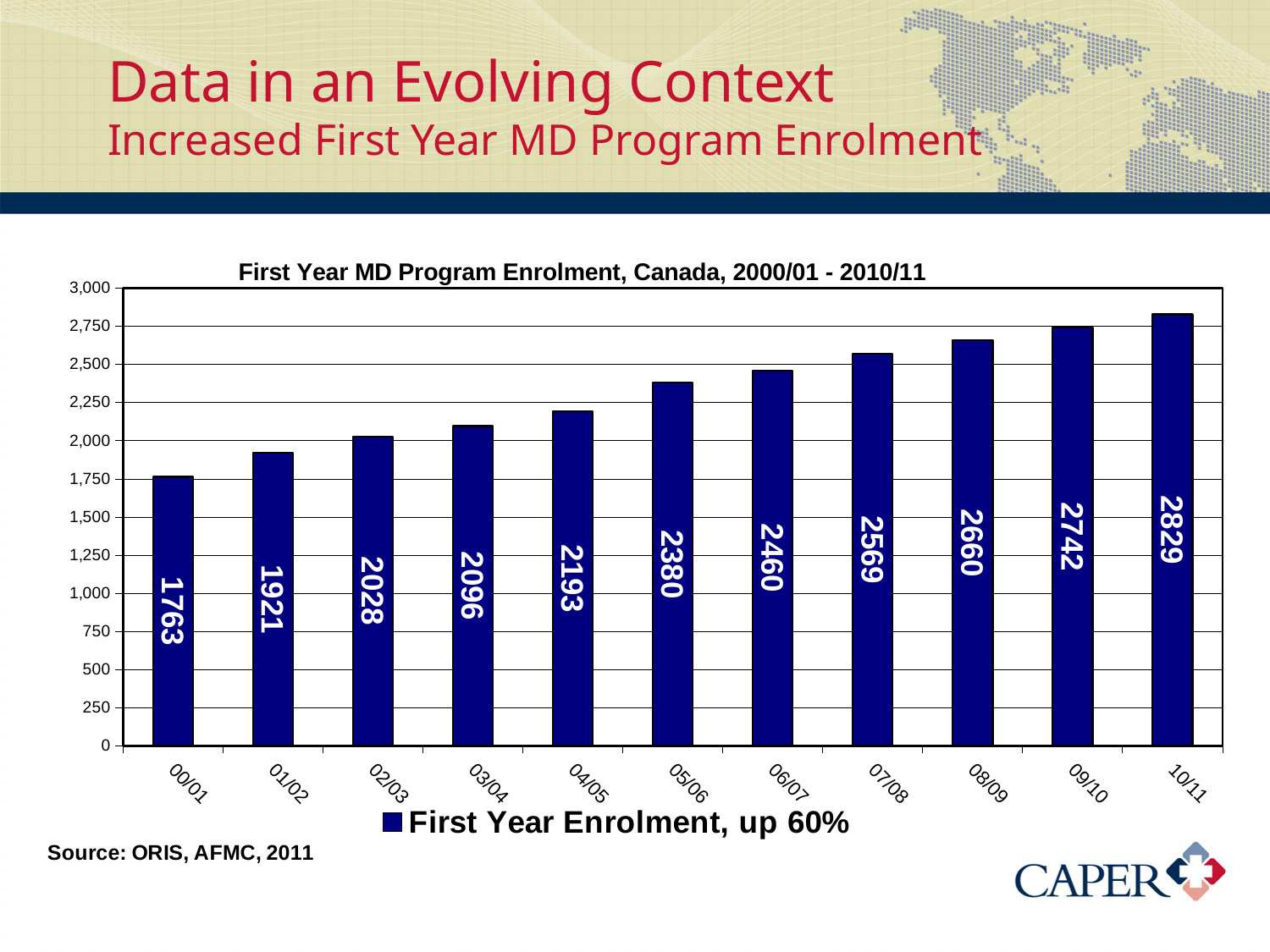
How many years are shown on the x axis? 11 Which is larger, the enrolment for 07/08 or for 06/07? 07/08 What is the first year enrolment value for 00/01? 1763 How many series does the legend list? 1 Do the enrolment values rise or fall from 00/01 to 10/11? Rise What is the first year enrolment value for 10/11? 2829 What kind of chart is shown on the slide? Bar chart Is the value for 03/04 greater or less than 2,000? greater Which year has the highest first year enrolment? 10/11 What is the difference in first year enrolment between 10/11 and 00/01? 1066 Which year has the lowest first year enrolment? 00/01 What is the first year enrolment value for 05/06? 2380